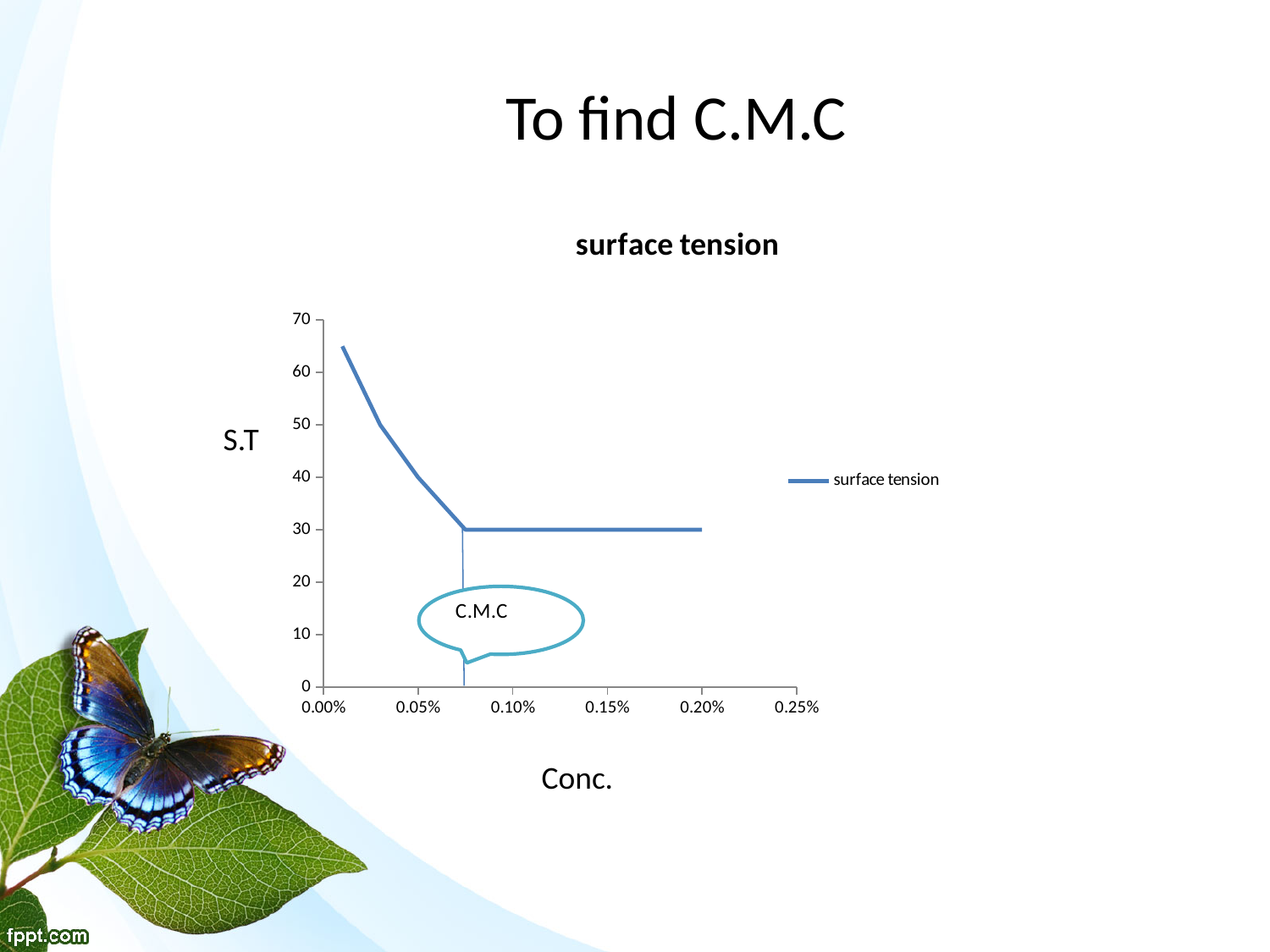
How many series does the legend list? 1 Is the surface tension value at 0.15% concentration greater or less than 40? less Is the surface tension value at 0.05% concentration greater or less than 30? greater Is the surface tension value at 0.10% concentration greater or less than 40? less What is the surface tension value at 0.20% concentration? 30 Does the surface tension rise or fall as concentration increases from 0.00% to 0.05%? fall Does the surface tension rise, fall or stay flat between 0.10% and 0.20% concentration? stay flat What kind of chart is shown on the slide? line chart Is the surface tension at 0.05% concentration larger or smaller than at 0.15% concentration? larger What is the name of the series shown in the legend? surface tension What is the title of the chart? surface tension